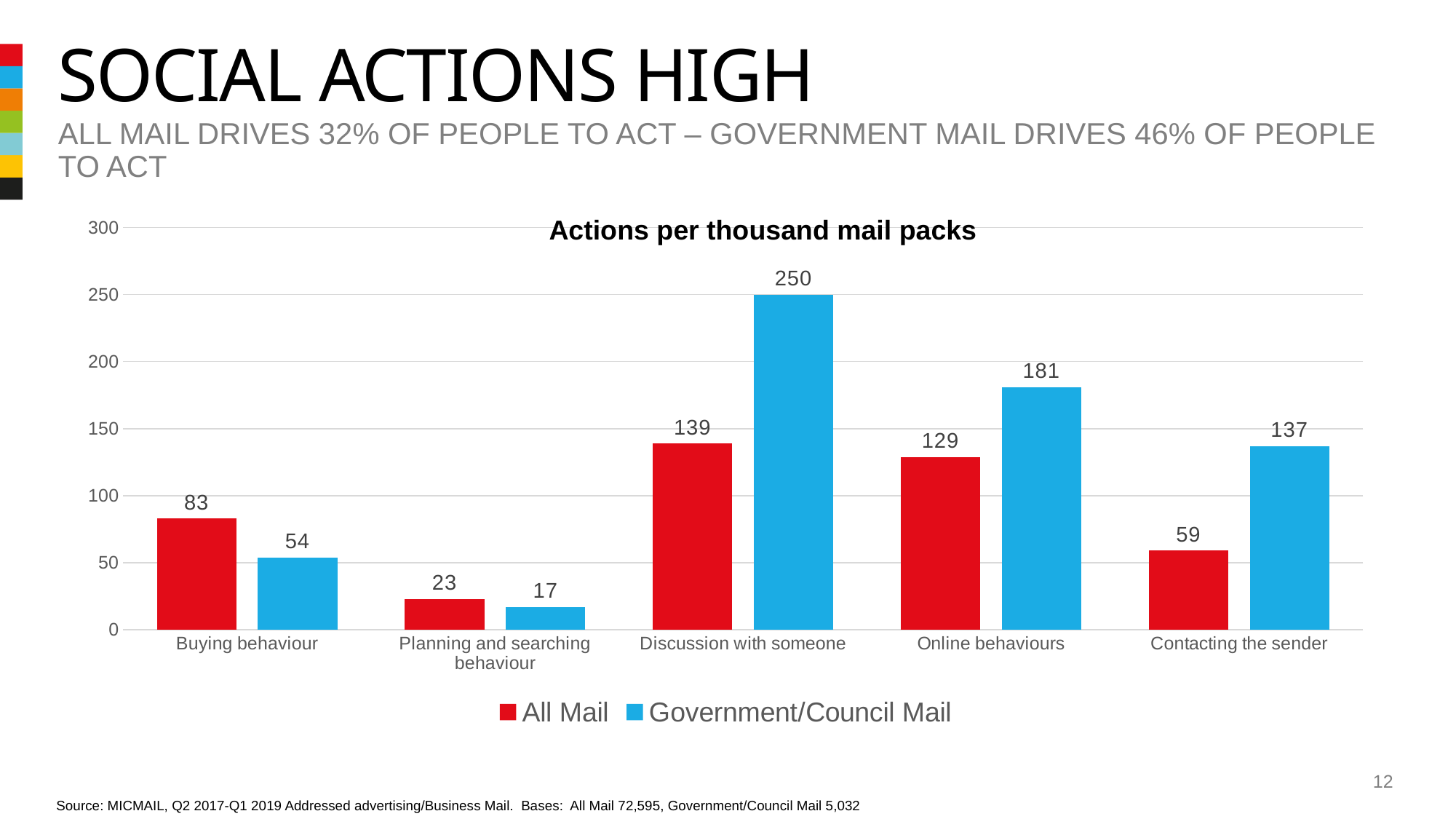
What is the value for Government/Council Mail in the Contacting the sender category? 137 What kind of chart is shown on the slide? Bar chart How many categories are shown on the x axis? 5 Which is larger in the Buying behaviour category: All Mail or Government/Council Mail? All Mail Which category has the lowest value for Government/Council Mail? Planning and searching behaviour What is the value for All Mail in the Buying behaviour category? 83 What is the value for Government/Council Mail in the Discussion with someone category? 250 What is the title of the chart? Actions per thousand mail packs How many series does the legend list? 2 Is the value for Government/Council Mail in the Online behaviours category greater or less than 150? greater Which category has the highest value for All Mail? Discussion with someone What is the difference between Government/Council Mail and All Mail in the Online behaviours category? 52